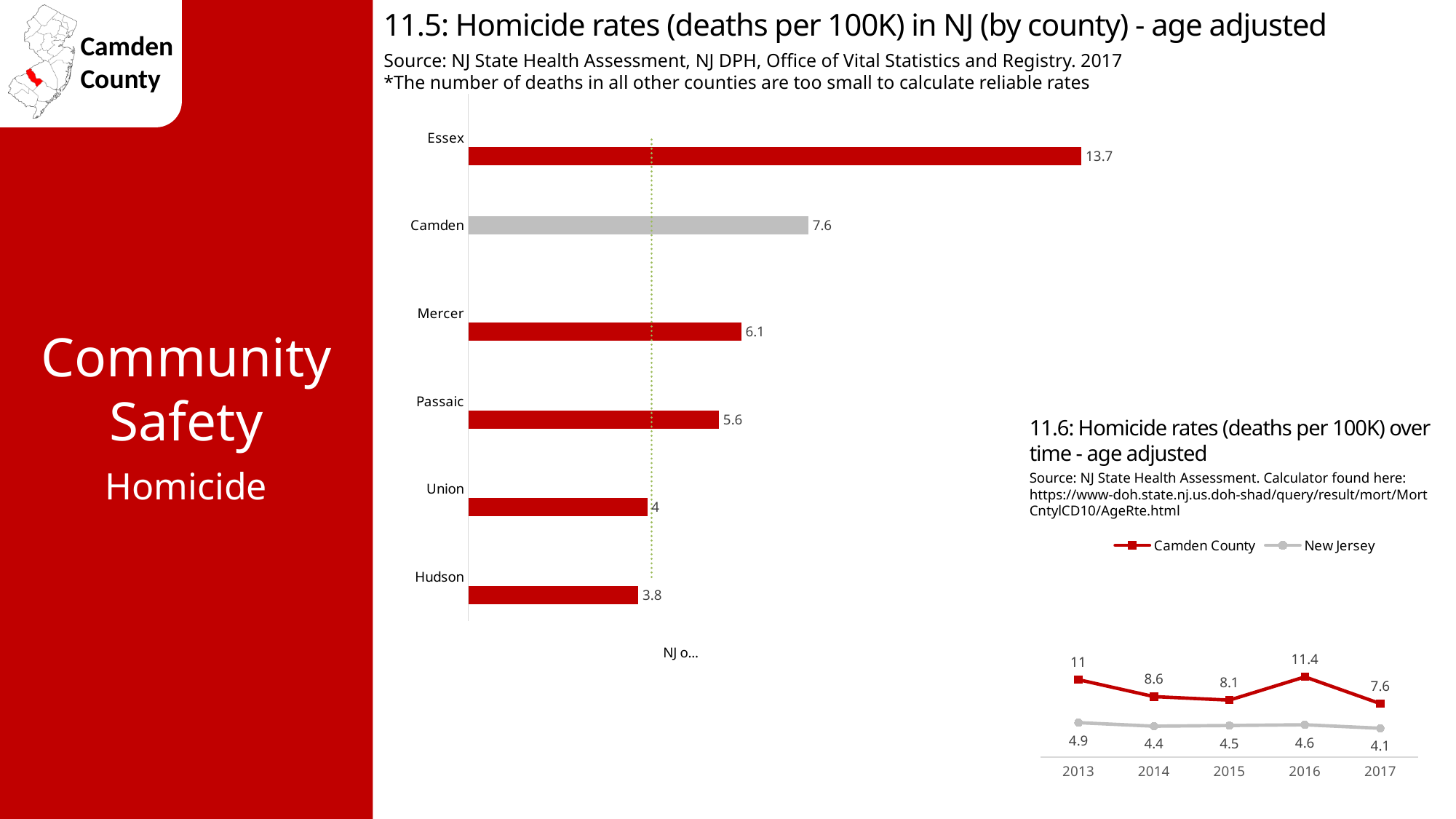
In chart 11.6 (homicide rates over time), what was the New Jersey rate in 2017? 4.1 In chart 11.5 (homicide rates by county), what is the homicide rate for Essex? 13.7 In chart 11.5 (homicide rates by county), which county has the lowest homicide rate? Hudson In chart 11.5 (homicide rates by county), what is the difference between the rates for Essex and Camden? 6.1 In chart 11.6 (homicide rates over time), what was the Camden County rate in 2016? 11.4 In chart 11.5 (homicide rates by county), what is the homicide rate for Camden? 7.6 In chart 11.6 (homicide rates over time), which is larger in 2013: the Camden County rate or the New Jersey rate? Camden County In chart 11.5 (homicide rates by county), how many counties are shown? 6 In chart 11.5 (homicide rates by county), which county has the highest homicide rate? Essex In chart 11.6 (homicide rates over time), what is the difference between the Camden County and New Jersey rates in 2017? 3.5 In chart 11.6 (homicide rates over time), how many series does the legend list? 2 In chart 11.5 (homicide rates by county), what kind of chart is used? Bar chart